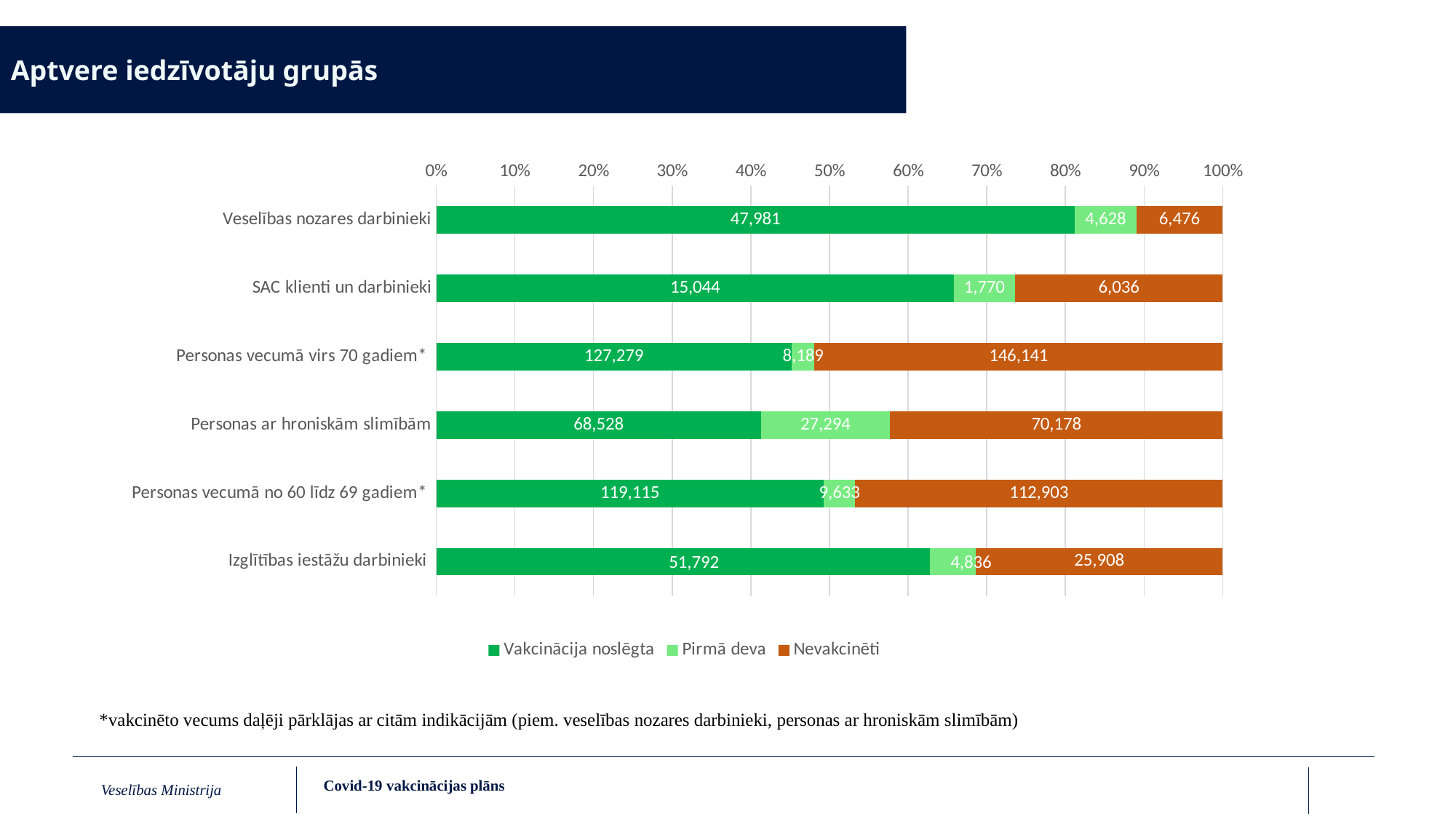
How many categories are shown on the chart? 6 Is the Vakcinācija noslēgta share for SAC klienti un darbinieki greater or less than 60%? greater What is the difference between the Nevakcinēti and Vakcinācija noslēgta values for Personas ar hroniskām slimībām? 1,650 Which category has the lowest Pirmā deva value? SAC klienti un darbinieki What is the Vakcinācija noslēgta value for Veselības nozares darbinieki? 47,981 What is the total of the three values for Izglītības iestāžu darbinieki? 82,536 What kind of chart is shown on the slide? Stacked bar chart What is the Nevakcinēti value for Personas vecumā virs 70 gadiem*? 146,141 Which category has the highest Nevakcinēti value? Personas vecumā virs 70 gadiem* What is the Pirmā deva value for Personas ar hroniskām slimībām? 27,294 How many series does the legend list? 3 Which is larger for Personas vecumā no 60 līdz 69 gadiem*: Vakcinācija noslēgta or Nevakcinēti? Vakcinācija noslēgta